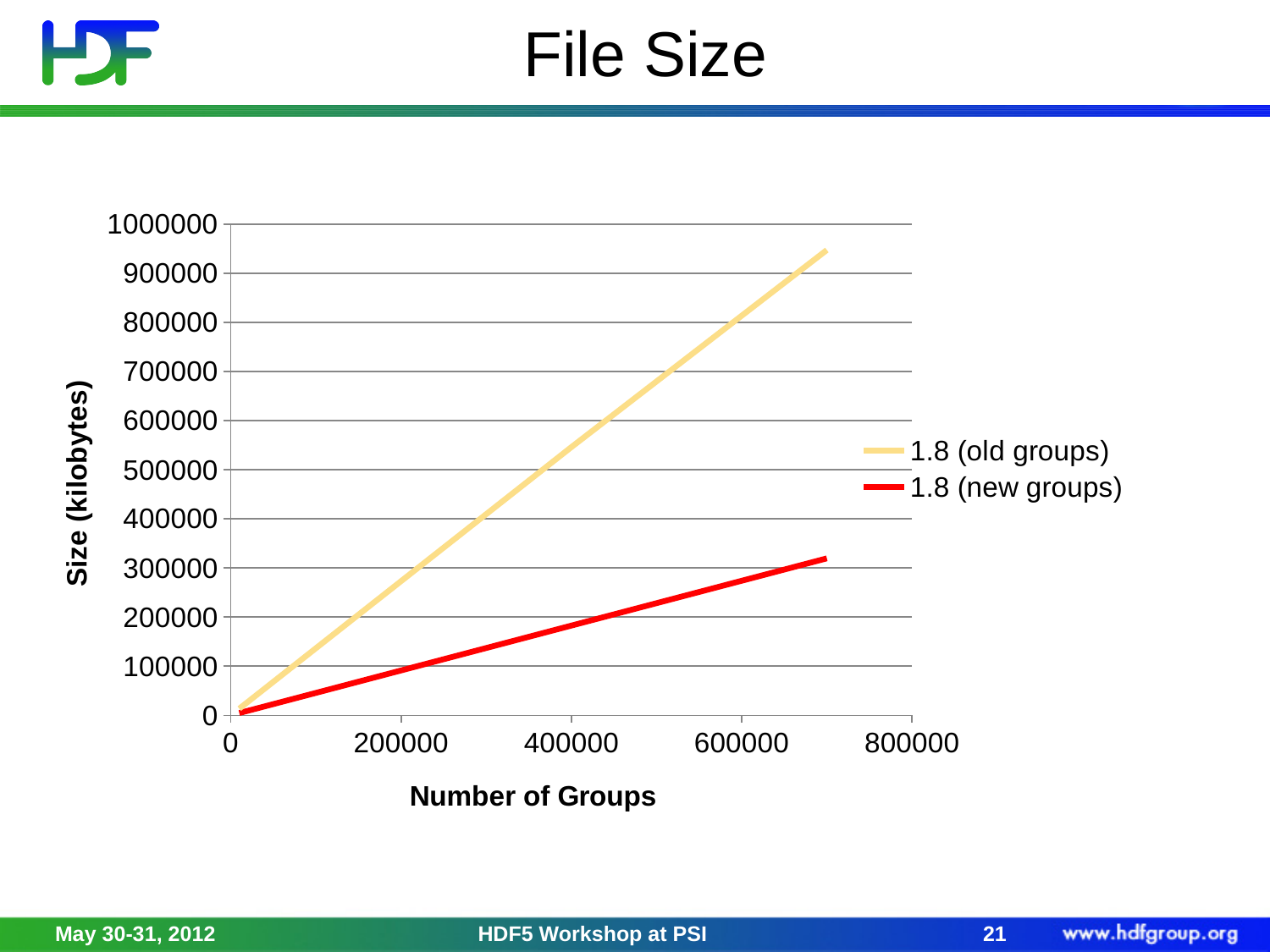
Which series reaches the highest file size on the chart? 1.8 (old groups) Is the file size for 1.8 (new groups) at 600000 groups greater or less than 400000 kilobytes? less Does the file size for 1.8 (old groups) rise or fall as the number of groups increases? rise What kind of chart is shown on the slide? line chart Does the file size for 1.8 (new groups) rise or fall as the number of groups increases? rise Which series is shown in red in the legend? 1.8 (new groups) Which series has the larger file size at 600000 groups, 1.8 (old groups) or 1.8 (new groups)? 1.8 (old groups) Is the file size for 1.8 (new groups) at 400000 groups greater or less than 300000 kilobytes? less What is the title of the y axis? Size (kilobytes) Which series has the lowest file size at 400000 groups? 1.8 (new groups) How many series does the legend list? 2 Is the file size for 1.8 (old groups) at 600000 groups greater or less than 700000 kilobytes? greater